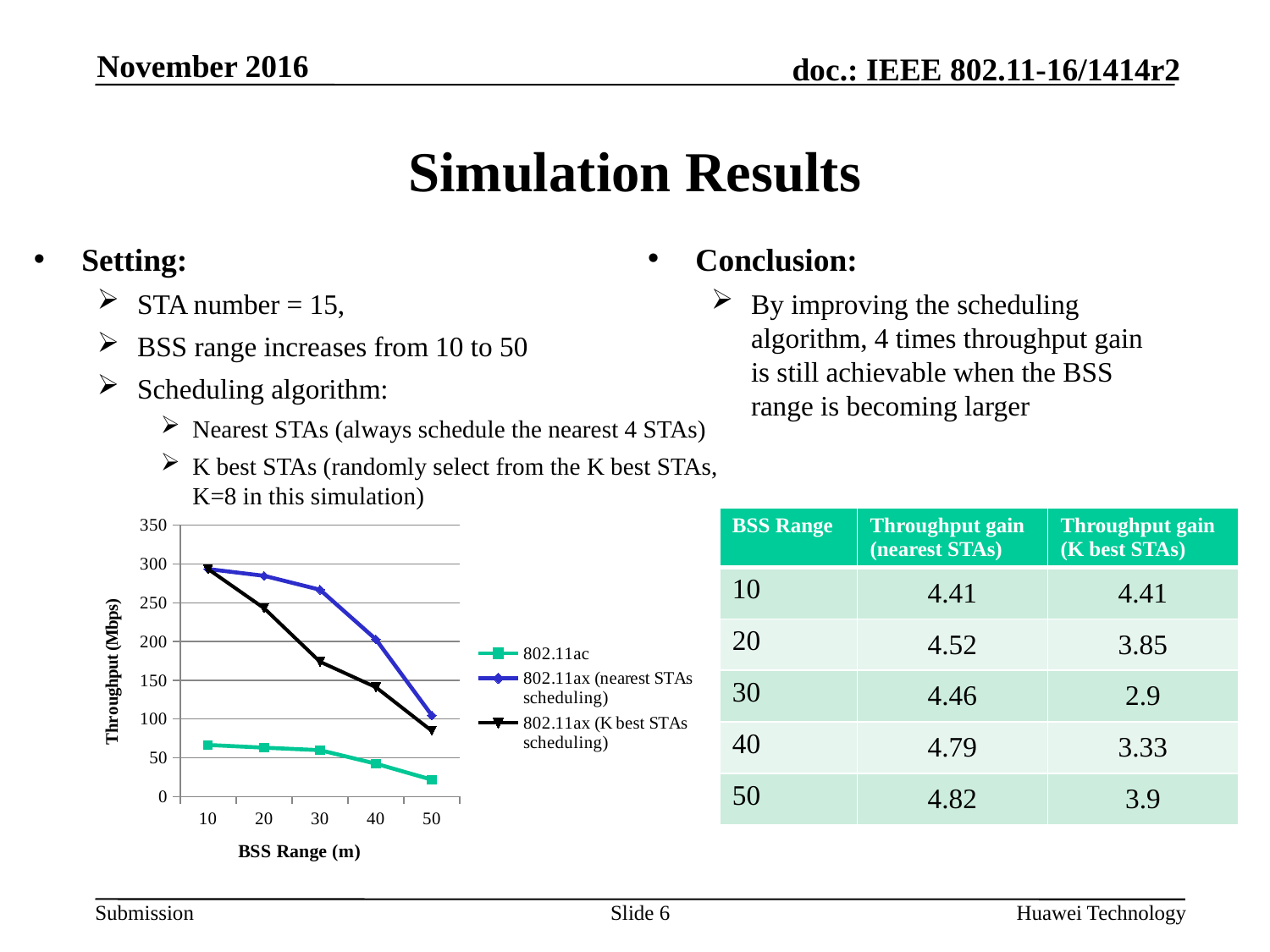
What is the title of the chart's y axis? Throughput (Mbps) Does the throughput for 802.11ac rise or fall as the BSS range increases from 10 m to 50 m? fall Is the throughput for 802.11ac at a BSS range of 50 m greater or less than 50 Mbps? less What kind of chart is shown on the slide? line chart How many series does the chart legend list? 3 At a BSS range of 30 m, which has higher throughput: 802.11ax (nearest STAs scheduling) or 802.11ax (K best STAs scheduling)? 802.11ax (nearest STAs scheduling) Is the throughput for 802.11ax (nearest STAs scheduling) at a BSS range of 40 m greater or less than 150 Mbps? greater Is the throughput for 802.11ax (nearest STAs scheduling) at a BSS range of 10 m greater or less than 250 Mbps? greater How many BSS range values are plotted along the x axis of the chart? 5 Which series has the highest throughput at a BSS range of 40 m? 802.11ax (nearest STAs scheduling) Which series has the lowest throughput at a BSS range of 50 m? 802.11ac